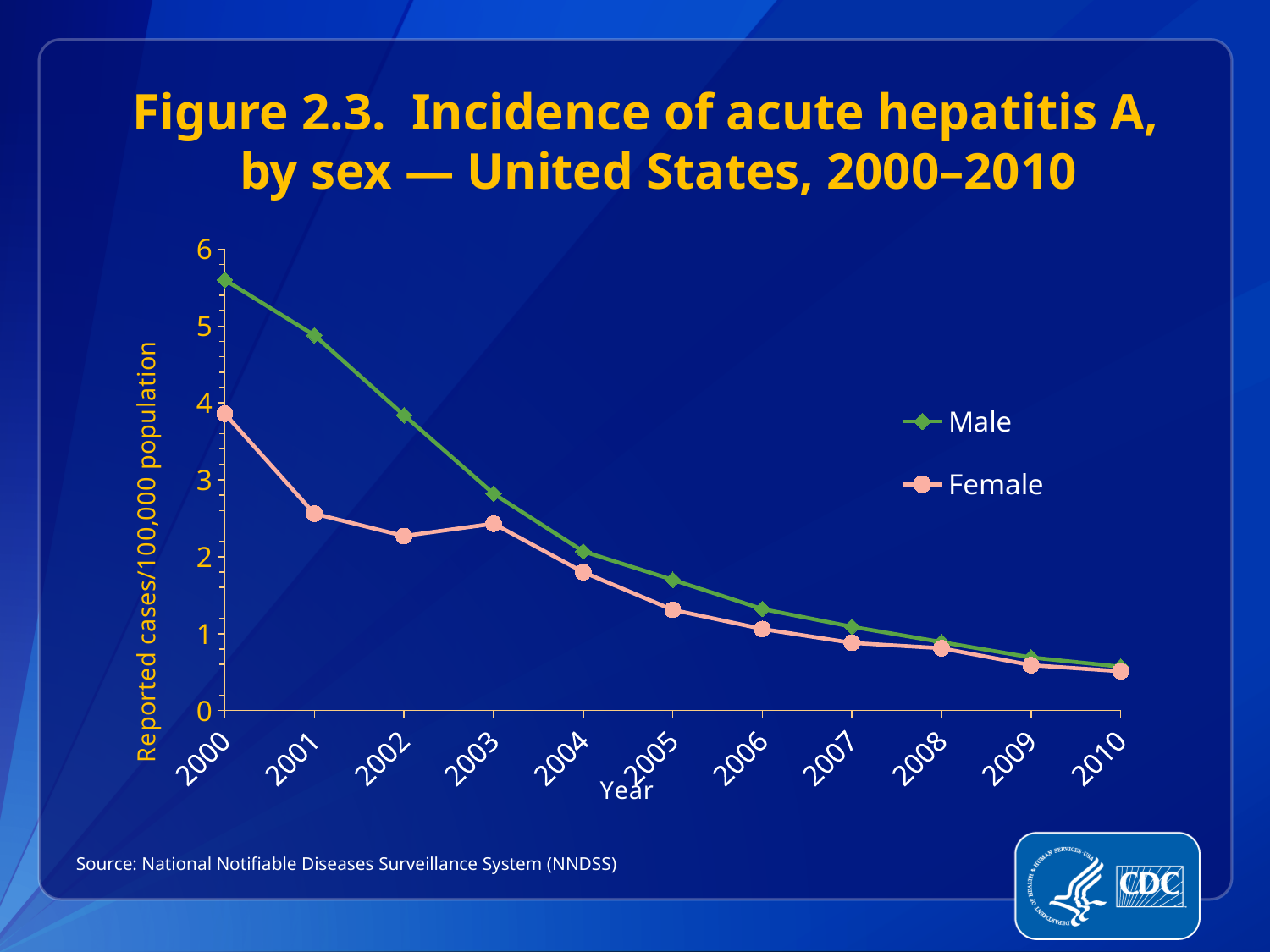
Is the Female value for 2004 greater or less than 2? less In which year is the Female incidence highest? 2000 How many years are plotted along the x axis? 11 In which year is the Male incidence highest? 2000 What is the label of the y axis? Reported cases/100,000 population In which year is the Male incidence lowest? 2010 Is the Male value for 2003 greater or less than 3? less Do the Male values rise or fall from 2000 to 2010? fall Is the Male value for 2000 greater or less than 5? greater What kind of chart is shown on the slide? line chart Which series has the larger value in 2002, Male or Female? Male How many series does the legend list? 2